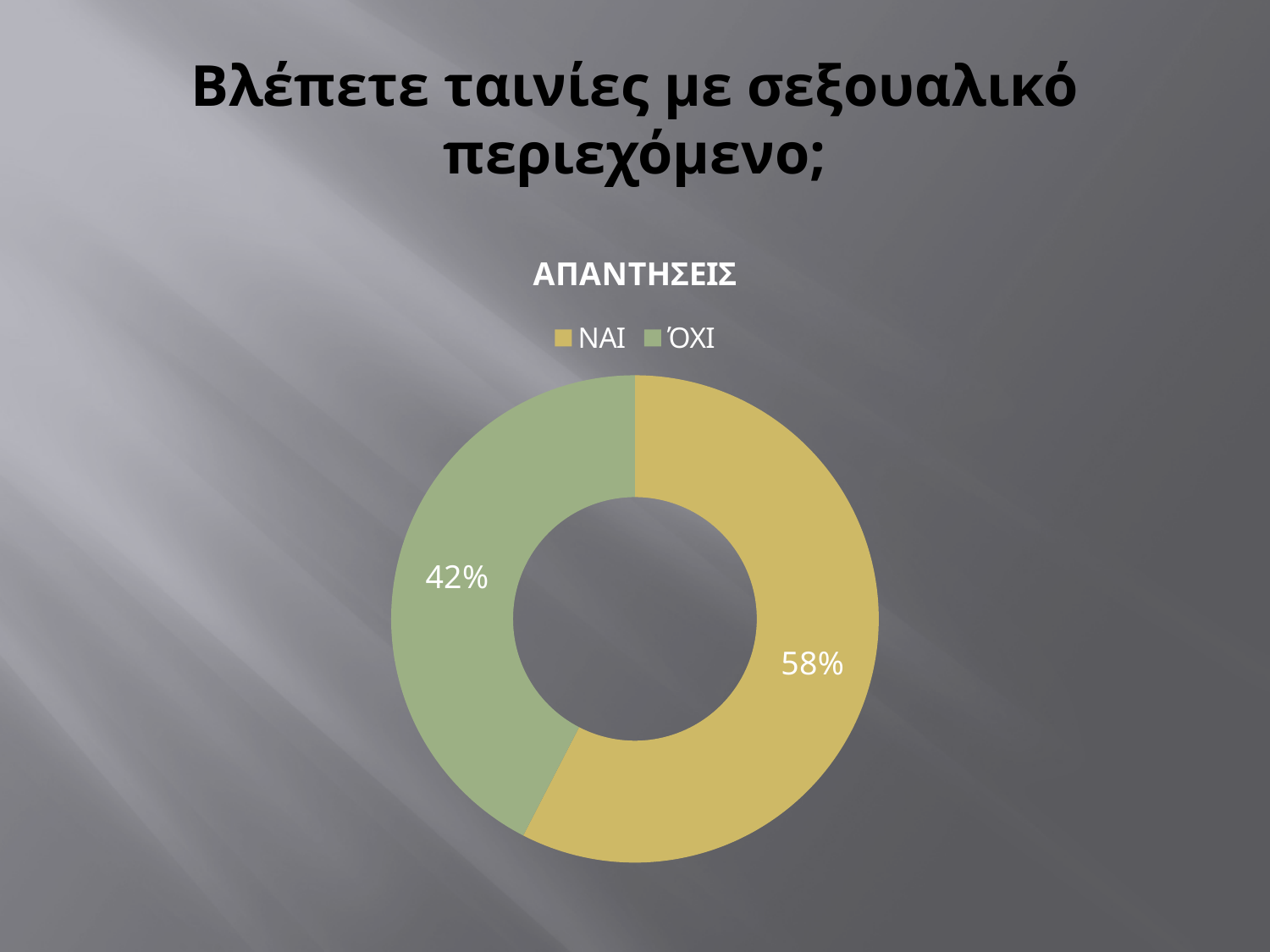
What is the title of the chart? ΑΠΑΝΤΗΣΕΙΣ Which answer has the largest share of the chart? ΝΑΙ Which is larger, the share for ΝΑΙ or the share for ΌΧΙ? ΝΑΙ Which answer has the smallest share of the chart? ΌΧΙ Is the share for ΝΑΙ greater or less than 50%? greater What colour represents ΌΧΙ in the chart? Green What is the difference in percentage points between ΝΑΙ and ΌΧΙ? 16 What percentage of responses are ΝΑΙ? 58% What kind of chart is shown on the slide? Doughnut (pie) chart How many entries does the legend list? 2 How many categories does the chart show? 2 What percentage of responses are ΌΧΙ? 42%